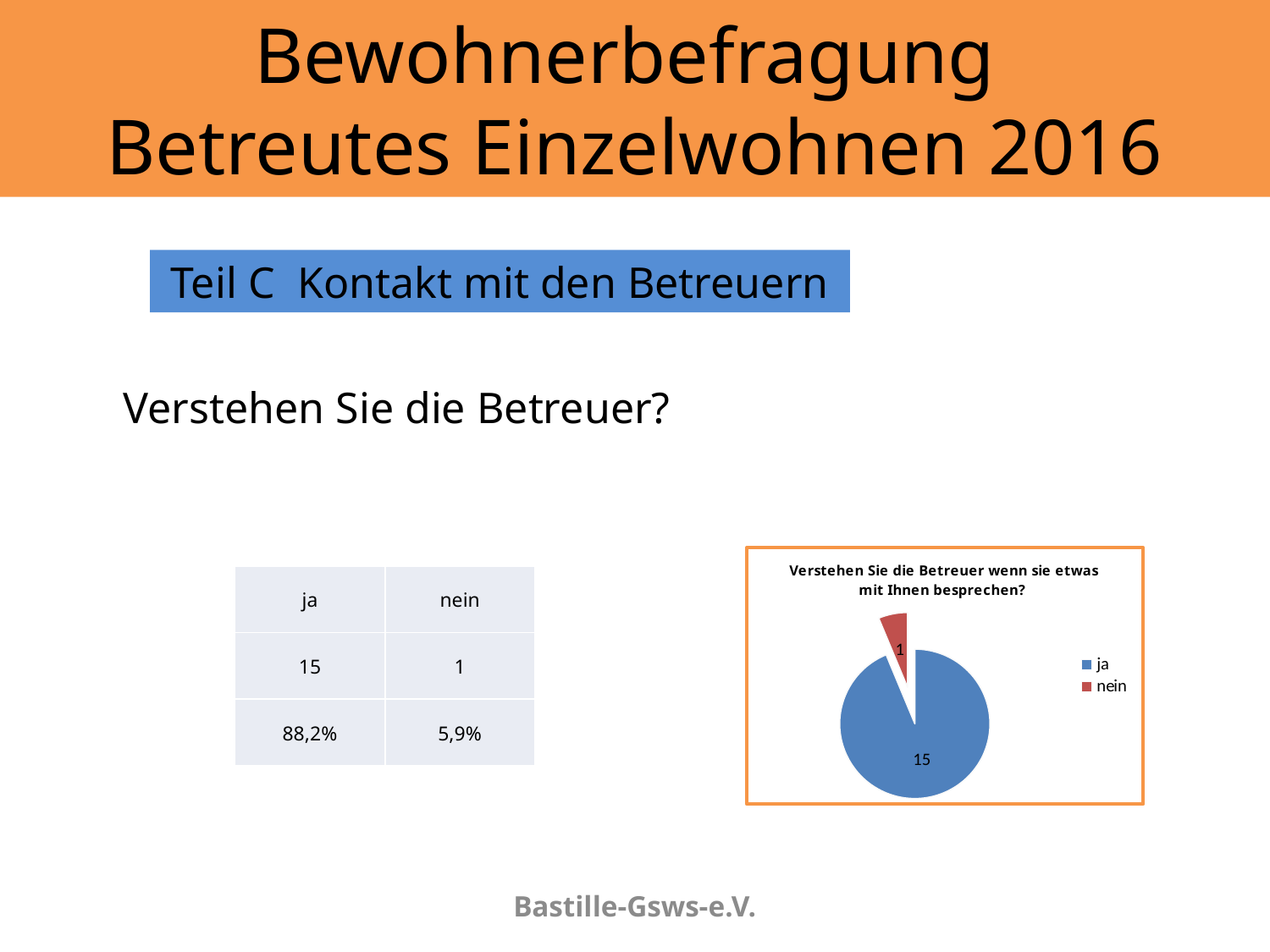
What colour is the "nein" slice in the pie chart? red How many entries does the legend of the pie chart list? 2 Which category has the smallest slice in the pie chart? nein What is the value of the "ja" slice in the pie chart? 15 What is the difference between the "ja" and "nein" values in the pie chart? 14 Which is larger in the pie chart, "ja" or "nein"? ja How many slices does the pie chart have? 2 What is the value of the "nein" slice in the pie chart? 1 What is the title of the pie chart? Verstehen Sie die Betreuer wenn sie etwas mit Ihnen besprechen? Which category has the largest slice in the pie chart? ja What is the total of the values shown in the pie chart? 16 What kind of chart is shown on the slide? pie chart